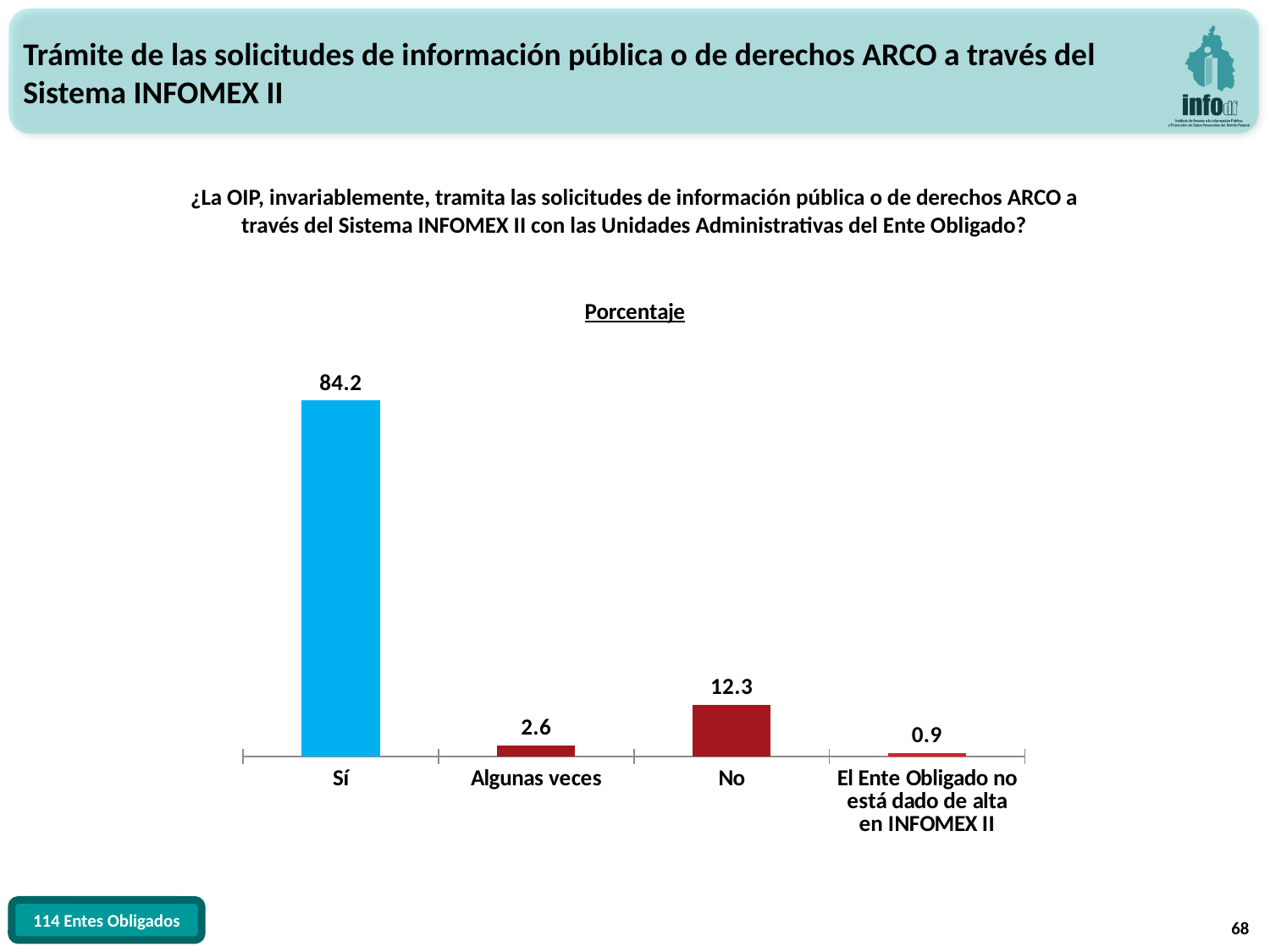
How many categories are shown in the chart? 4 Which is larger, the value for "No" or the value for "Algunas veces"? No What is the difference between the values for "No" and "Algunas veces"? 9.7 What is the value for "El Ente Obligado no está dado de alta en INFOMEX II"? 0.9 Which category has the highest value? Sí What is the difference between the values for "Sí" and "No"? 71.9 What is the value for "Algunas veces"? 2.6 What is the value for "Sí"? 84.2 What is the title of the chart? Porcentaje What kind of chart is shown on the slide? Bar chart What is the value for "No"? 12.3 Which category has the lowest value? El Ente Obligado no está dado de alta en INFOMEX II